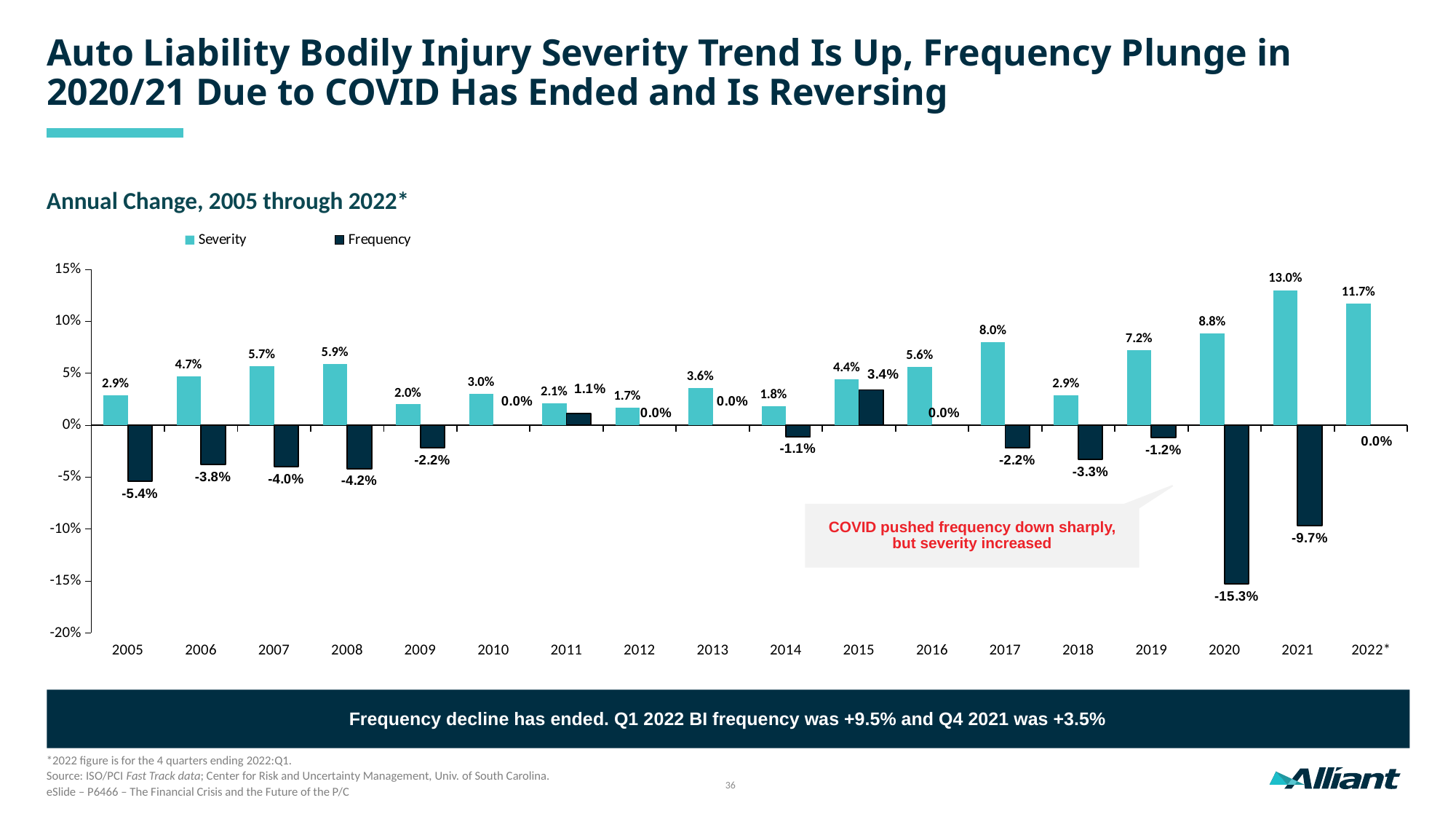
How many years are shown on the x axis? 18 Which year has the highest Severity value? 2021 What is the Severity value for 2017? 8.0% What kind of chart is shown on the slide? Bar chart What is the Frequency value for 2015? 3.4% How many series does the legend list? 2 What is the Frequency value for 2020? -15.3% What is the title of the chart? Annual Change, 2005 through 2022* Which year has the lowest Frequency value? 2020 What is the Severity value for 2021? 13.0% Which is larger, the Severity value for 2008 or the Severity value for 2007? 2008 What is the difference between the Severity values for 2021 and 2022*? 1.3%